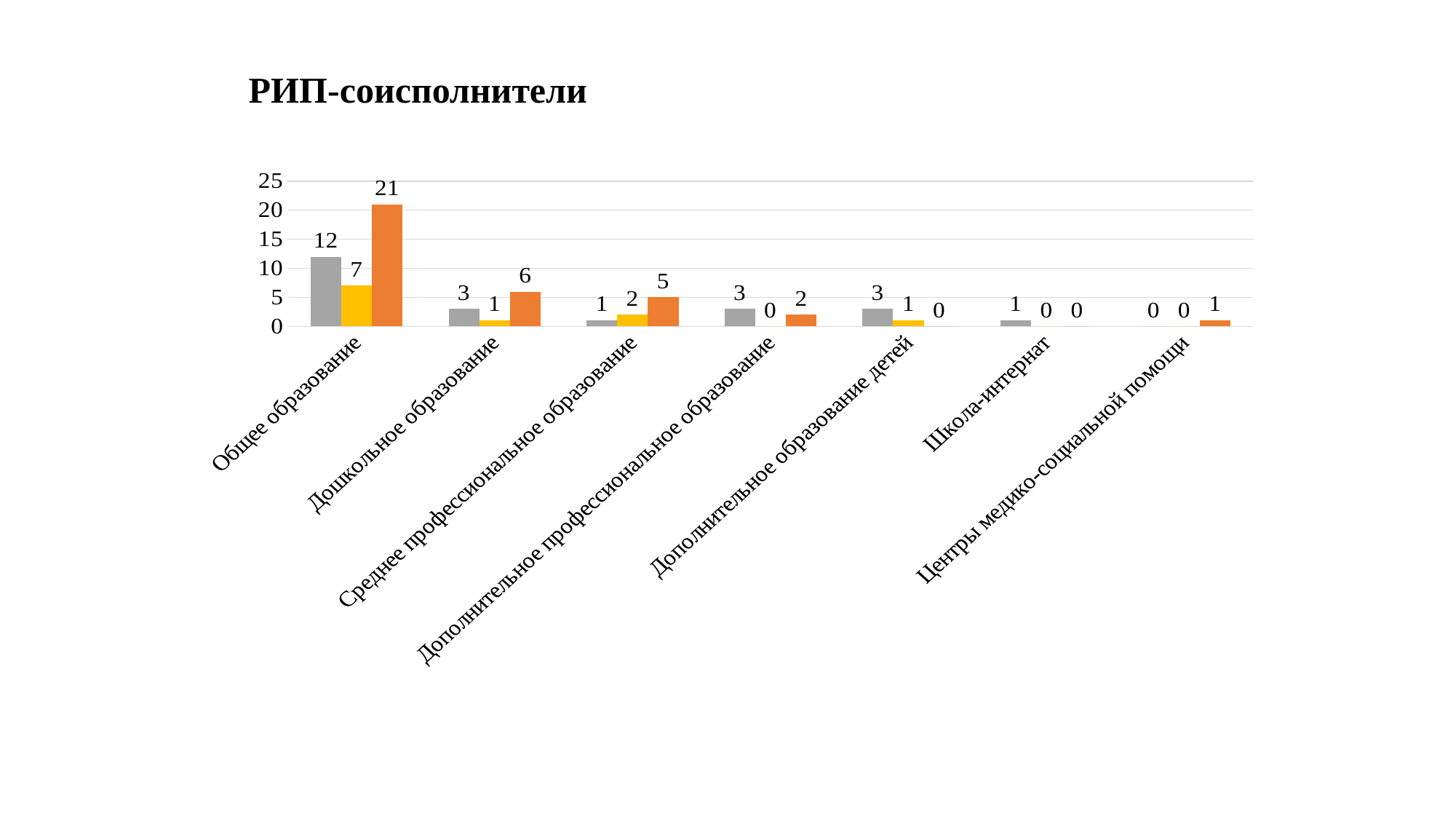
What is the value of the yellow bar for Дошкольное образование? 1 Which is larger for Дошкольное образование, the grey bar or the orange bar? the orange bar What is the title of the chart? РИП-соисполнители What is the value of the orange bar for Среднее профессиональное образование? 5 How many categories are shown on the x axis of the chart? 7 What is the value of the orange bar for Общее образование? 21 What is the value of the grey bar for Общее образование? 12 What is the difference between the orange bar and the grey bar for Общее образование? 9 What is the value of the orange bar for Центры медико-социальной помощи? 1 What is the total of the three bars for Дошкольное образование? 10 What type of chart is shown on the slide? bar chart Which category has the highest orange bar? Общее образование